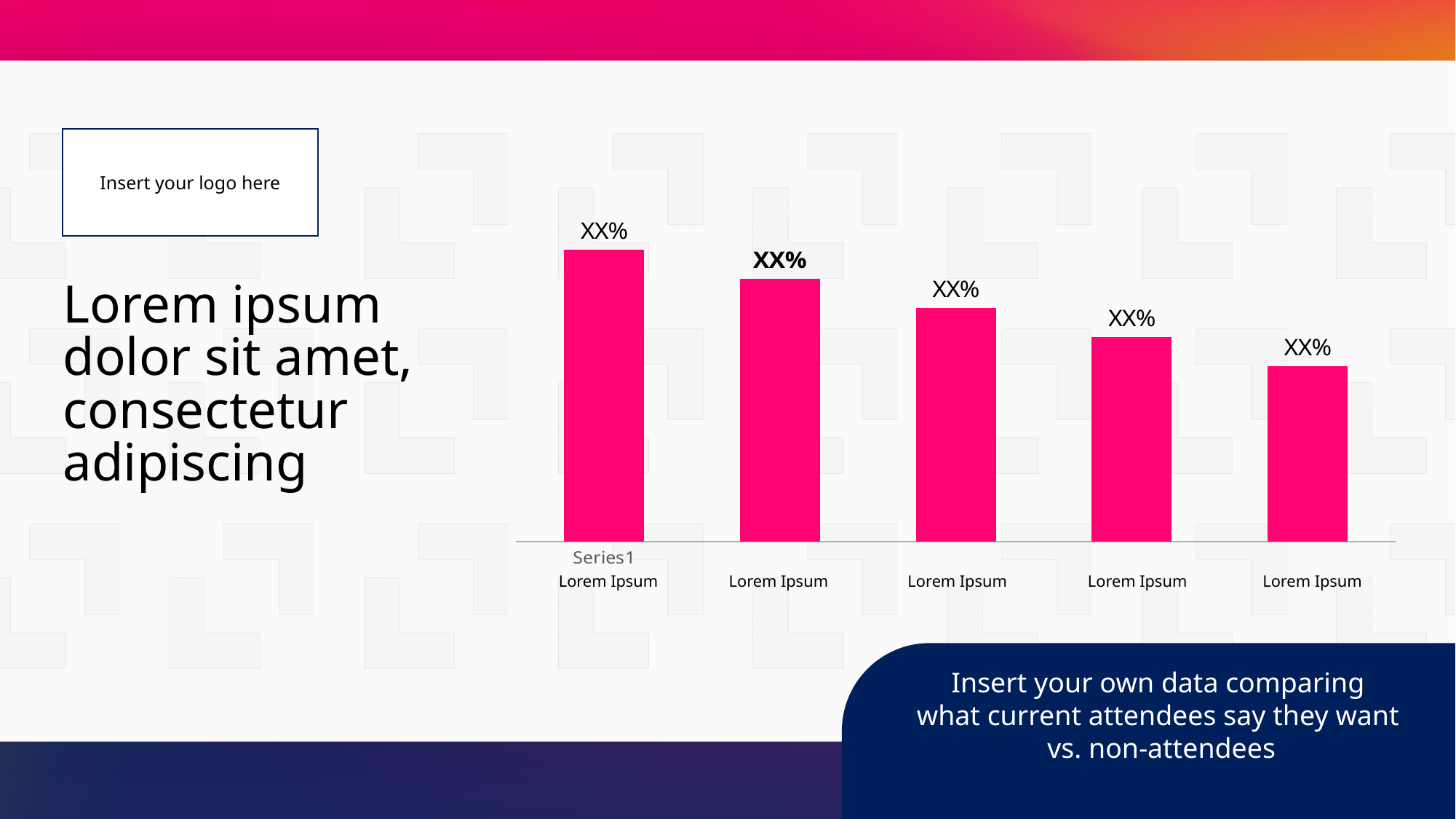
How many bars are plotted in the chart? 5 Is the leftmost bar taller or shorter than the rightmost bar? taller Do the bar values rise or fall from left to right across the chart? fall What kind of chart is shown on the slide? bar chart What placeholder text is shown as the data label above each bar? XX% Which bar in the chart is the shortest? the rightmost (fifth) bar What colour are the bars in the chart? pink Which bar in the chart is the tallest? the leftmost (first) bar